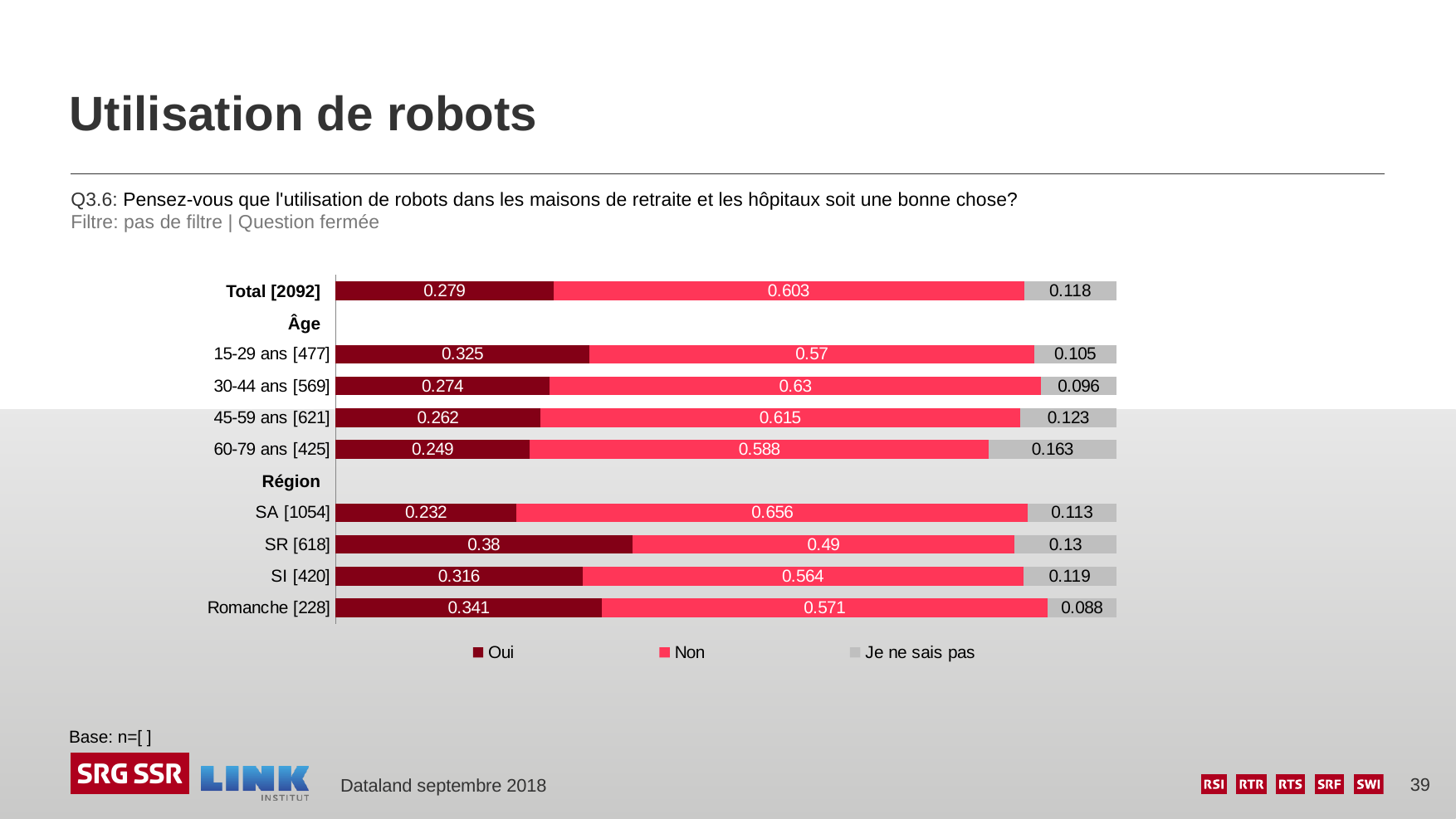
Which is larger, the 'Non' value for 15-29 ans [477] or for 45-59 ans [621]? 45-59 ans [621] What is the difference between the 'Oui' values for SR [618] and SA [1054]? 0.148 Which series is shown in light grey in the legend? Je ne sais pas What is the 'Je ne sais pas' value for 60-79 ans [425]? 0.163 What is the 'Non' value for 30-44 ans [569]? 0.63 What is the 'Oui' value for Total [2092]? 0.279 Which category has the lowest 'Je ne sais pas' value? Romanche [228] What kind of chart is shown on the slide? Stacked bar chart Which category has the highest 'Oui' value? SR [618] What is the 'Oui' value for SR [618]? 0.38 How many series does the legend list? 3 Which category has the highest 'Non' value? SA [1054]